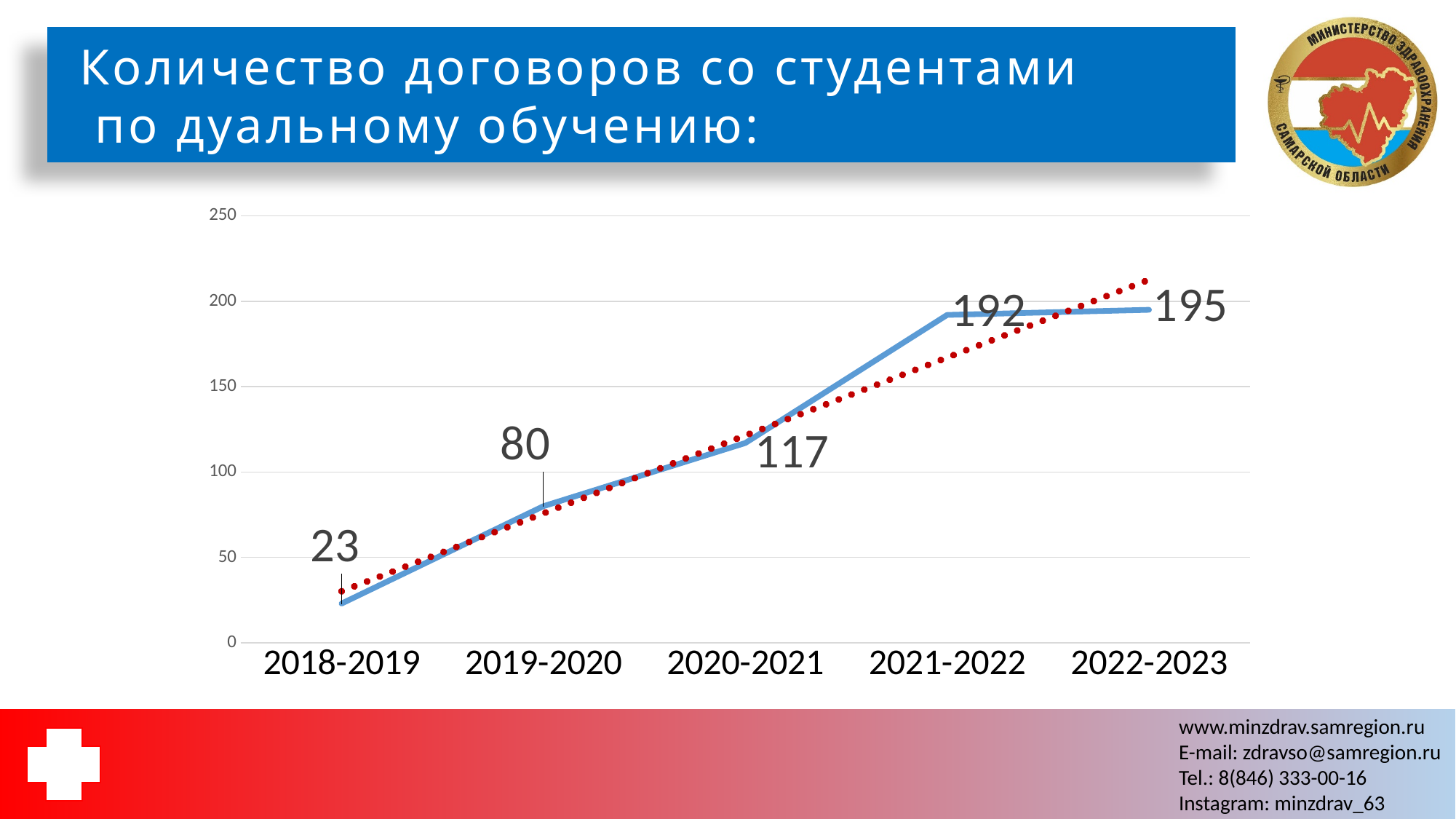
How many periods are shown on the x axis? 5 Which period has the highest value? 2022-2023 Which period has the lowest value? 2018-2019 Which is larger, the value for 2019-2020 or the value for 2020-2021? 2020-2021 Is the value for 2021-2022 greater or less than 150? greater What is the value for 2018-2019? 23 What kind of chart is shown on the slide? line chart What is the difference between the values for 2021-2022 and 2019-2020? 112 Do the values rise or fall from 2018-2019 to 2022-2023? rise What is the value for 2020-2021? 117 What is the value for 2022-2023? 195 What is the difference between the values for 2020-2021 and 2018-2019? 94